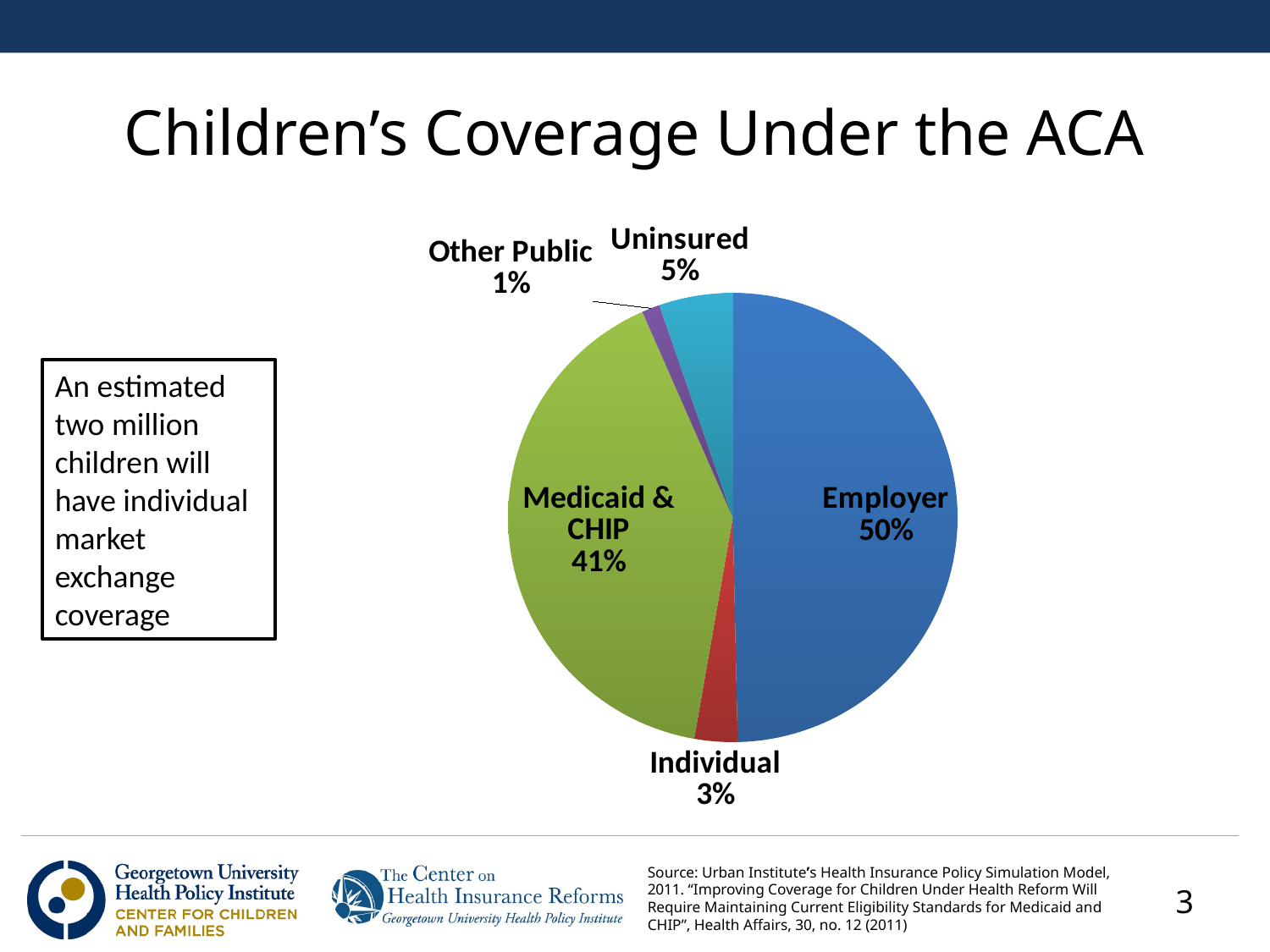
What share of children's coverage is Other Public? 1% What share of children's coverage is Individual? 3% Which category has the largest share of the pie? Employer What type of chart is shown on the slide? pie chart How many categories are shown in the pie chart? 5 Which is larger, the Uninsured share or the Individual share? Uninsured What share of children's coverage is Uninsured? 5% What share of children's coverage is Medicaid & CHIP? 41% What is the difference in percentage points between Employer and Medicaid & CHIP? 9 What is the title of the slide containing the pie chart? Children's Coverage Under the ACA Which category has the smallest share of the pie? Other Public What share of children's coverage is Employer? 50%